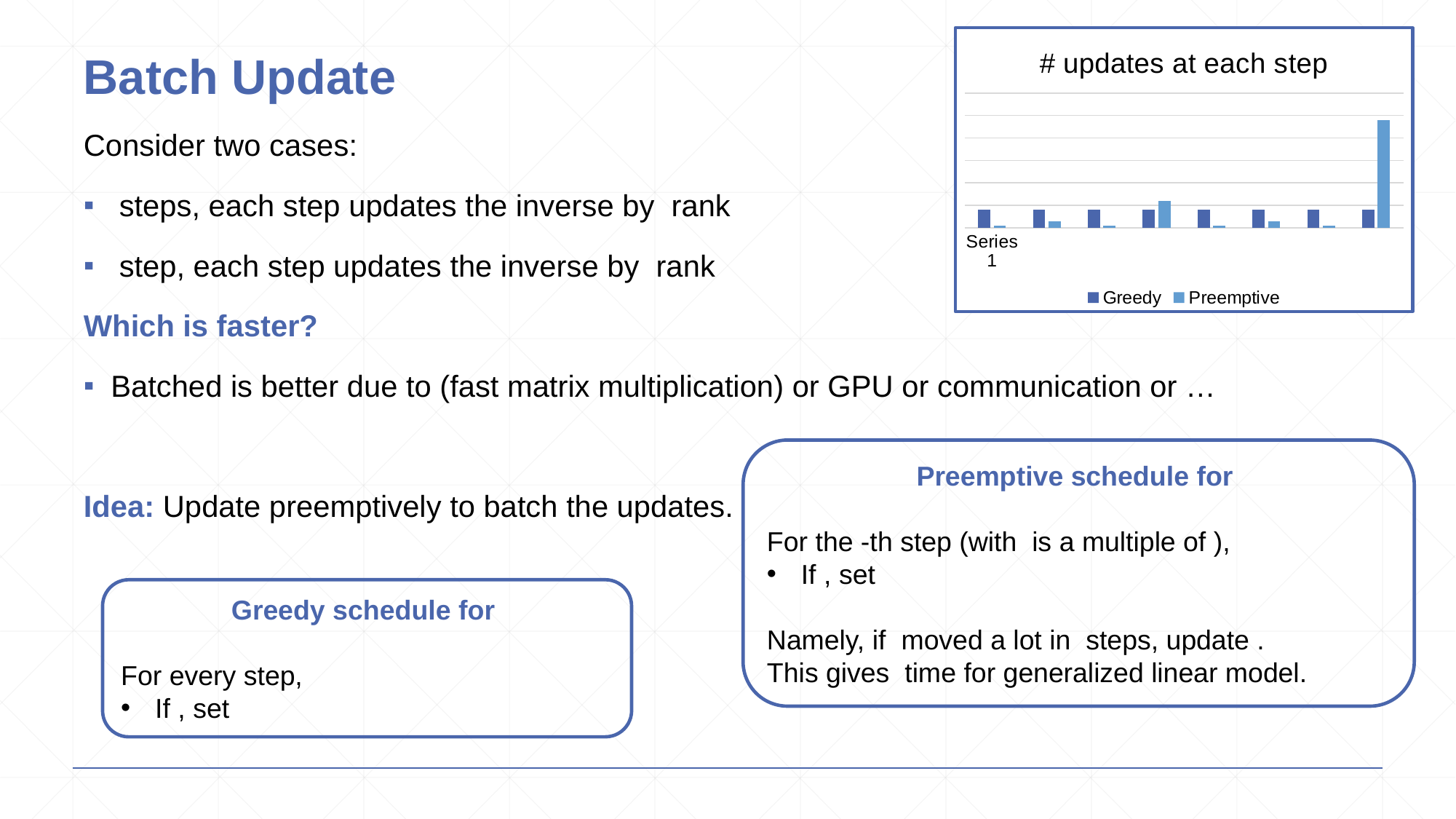
In the first (leftmost) group of bars, which series is larger, Greedy or Preemptive? Greedy What are the names of the series in the chart's legend? Greedy and Preemptive How many groups of bars (steps) are plotted in the chart? 8 In the last (rightmost) group of bars, which series is larger, Greedy or Preemptive? Preemptive What is the title of the chart? # updates at each step Which series has the lowest bar in the first group? Preemptive Which series has the single tallest bar in the chart? Preemptive What kind of chart is shown on the slide? bar chart Do the Greedy bars rise, fall, or stay roughly constant across the steps? stay roughly constant How many series does the chart's legend list? 2